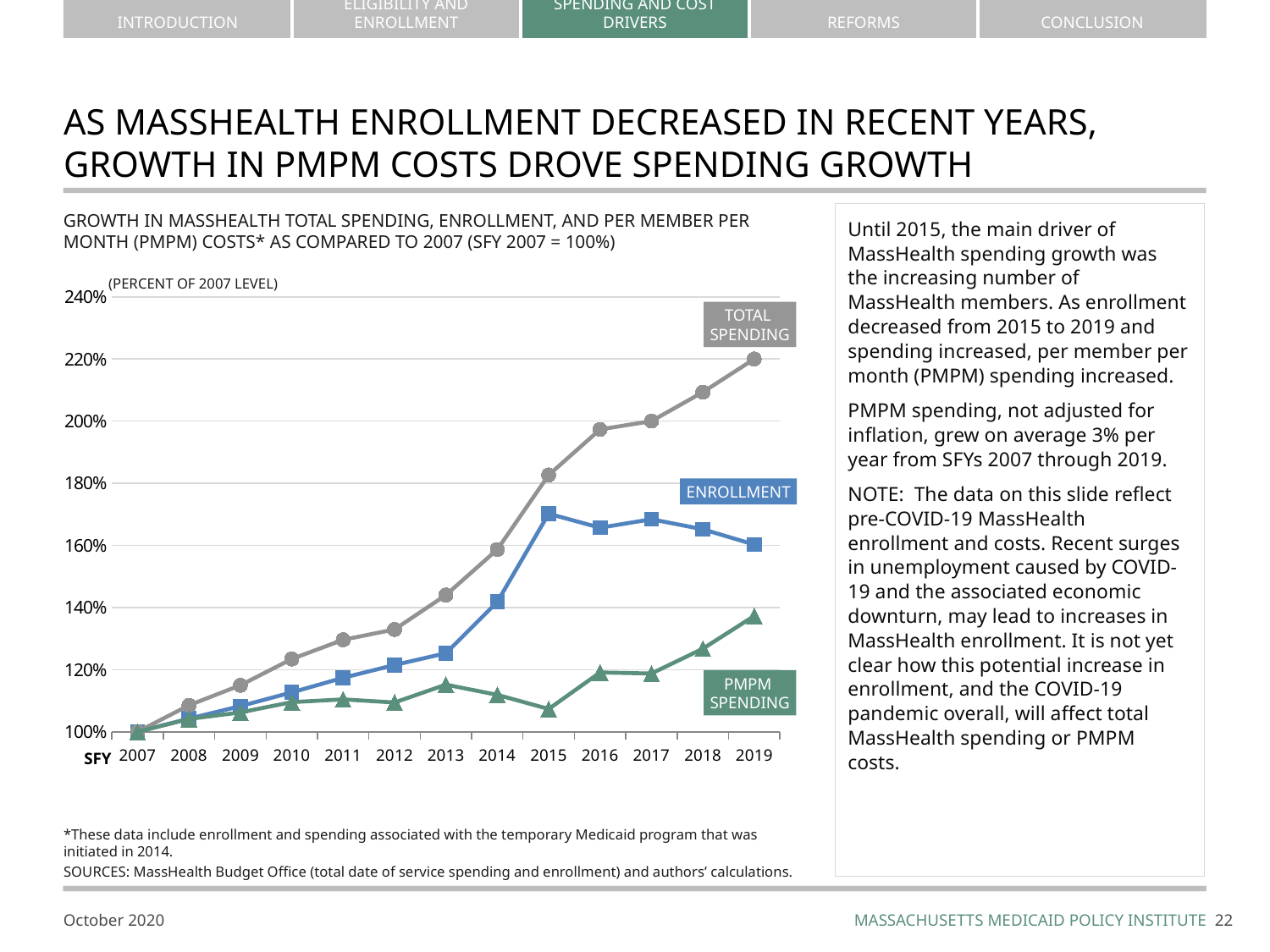
Is the value for Enrollment in 2015 greater or less than 160%? greater Which series has the lowest value in 2019? PMPM Spending Which series has the highest value in 2019? Total Spending How many fiscal years are shown along the x axis of the chart? 13 What kind of chart is shown on the slide? line chart How many series are plotted on the chart? 3 In 2013, which is larger: Enrollment or PMPM Spending? Enrollment Does Enrollment rise or fall from 2015 to 2019? fall Is the value for Total Spending in 2019 greater or less than 200%? greater Is the value for PMPM Spending in 2015 greater or less than 120%? less Does Total Spending rise or fall from 2007 to 2019? rise What is the value of all three series in SFY 2007? 100%